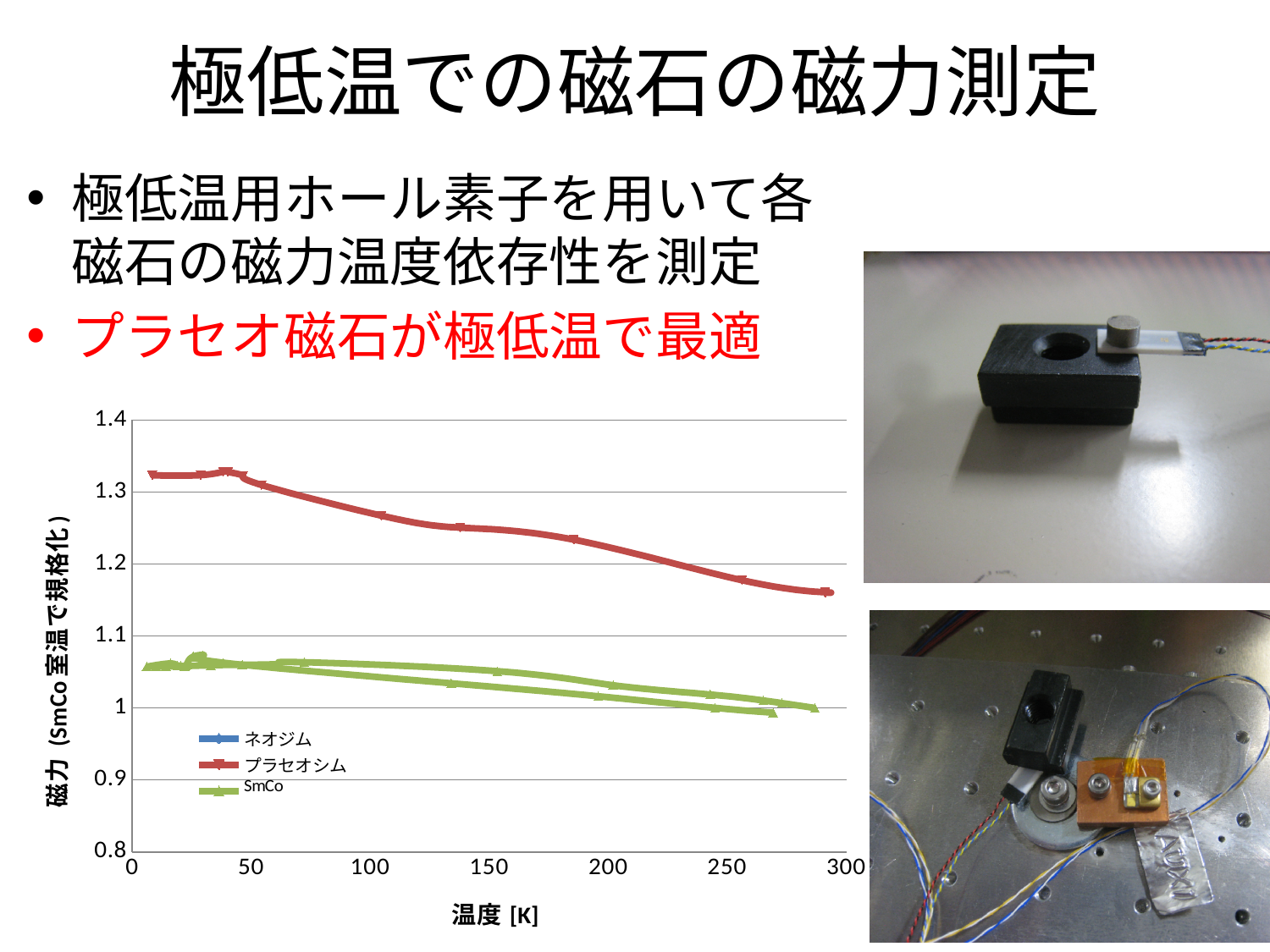
Which series has the highest magnetic force values across the temperature range? プラセオシム What is the x-axis title of the chart? 温度 [K] What kind of chart is shown on the slide? line chart Does the プラセオシム series rise or fall as temperature increases from 50 K to 300 K? fall Is the value for SmCo at 50 K greater or less than 1.1? less At 150 K, which series has the larger value, プラセオシム or SmCo? プラセオシム Is the value for プラセオシム at 10 K greater or less than 1.3? greater Is the value for プラセオシム at 250 K greater or less than 1.2? less How many series does the chart legend list? 3 What are the three series listed in the chart legend? ネオジム, プラセオシム, SmCo